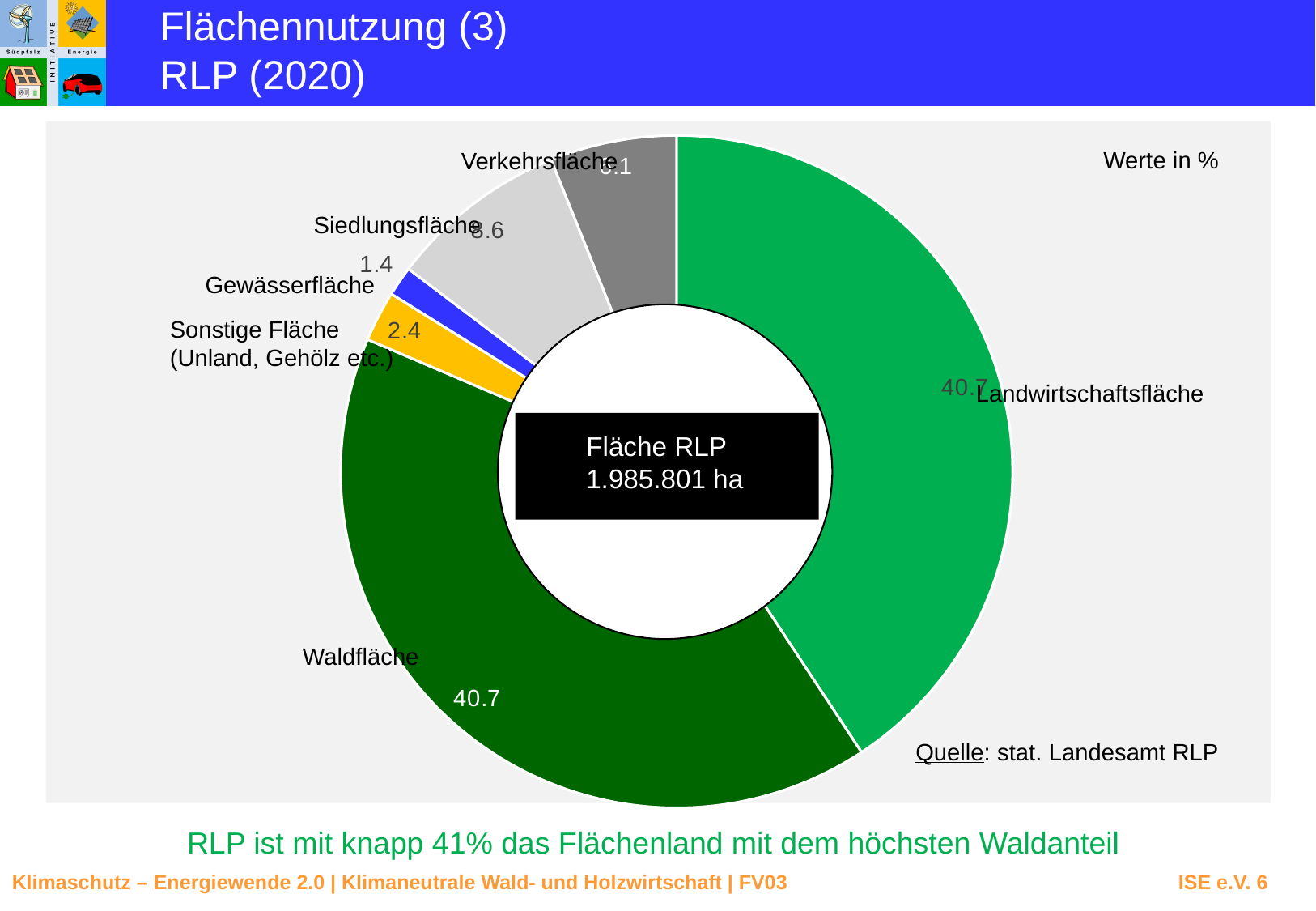
What type of chart is shown on the slide? Pie (donut) chart What is the value for Landwirtschaftsfläche? 40.7 What is the value for Sonstige Fläche (Unland, Gehölz etc.)? 2.4 What is the value for Gewässerfläche? 1.4 Which category has the smallest share of the chart? Gewässerfläche What total area is stated in the centre of the chart? 1.985.801 ha In what unit are the chart values given? % What is the value for Waldfläche? 40.7 What is the difference between the values for Sonstige Fläche and Gewässerfläche? 1.0 How many categories are shown in the chart? 6 Which is larger, Sonstige Fläche or Gewässerfläche? Sonstige Fläche What is the combined share of Waldfläche and Landwirtschaftsfläche? 81.4